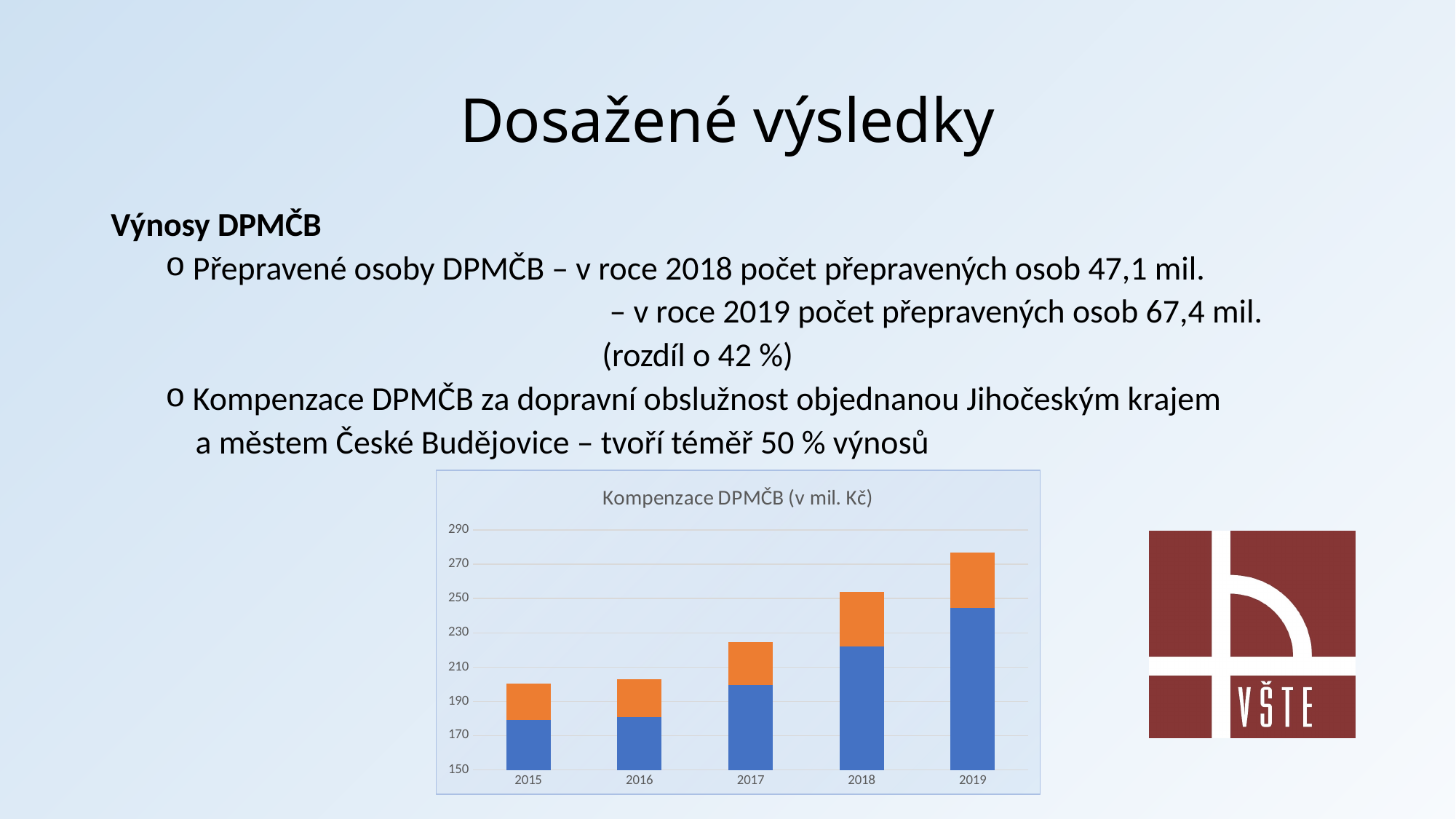
What is the title of the chart? Kompenzace DPMČB (v mil. Kč) Which year has the larger total bar, 2016 or 2018? 2018 Is the total value for 2015 greater or less than 210? less Which year has the highest total bar in the chart? 2019 Is the total value for 2018 greater or less than 250? greater What two colours are used for the stacked segments in the chart? blue and orange Which year has the lowest total bar in the chart? 2015 How many years are shown on the x axis of the chart? 5 Is the total value for 2019 greater or less than 270? greater Do the total bar heights rise or fall from 2015 to 2019? rise What kind of chart is shown on the slide? stacked bar chart